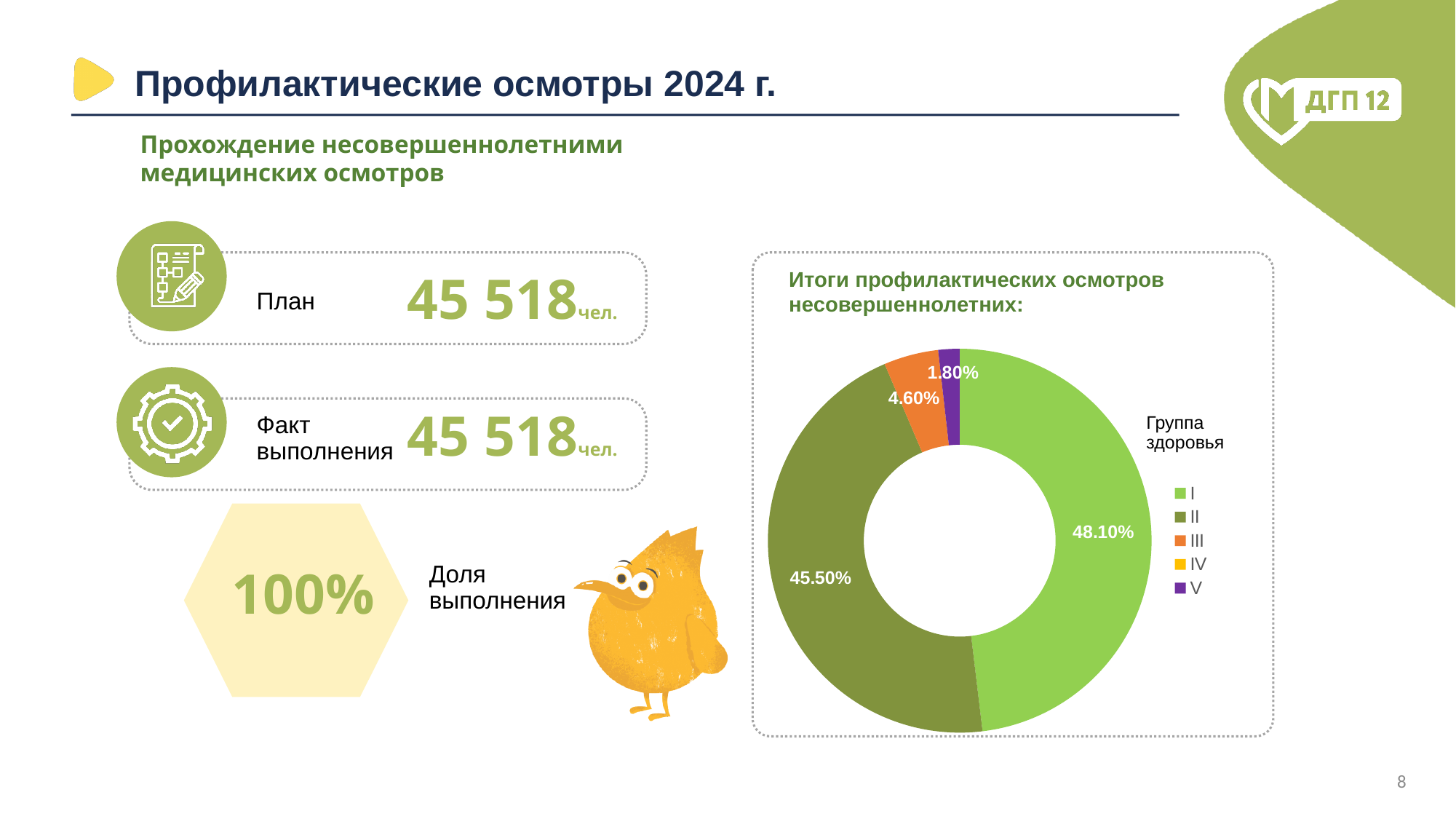
What share of the doughnut chart is labelled for health group V? 1.80% What colour is the slice for health group III in the doughnut chart? Orange Which labelled health group has the smallest share in the doughnut chart? V What share of the doughnut chart is labelled for health group II? 45.50% What kind of chart is shown on the slide? Doughnut (pie) chart What share of the doughnut chart is labelled for health group III? 4.60% What share of the doughnut chart is labelled for health group I? 48.10% What is the difference in percentage points between health group III and health group V in the doughnut chart? 2.80% How many health groups does the legend of the doughnut chart list? 5 Which health group has the largest share in the doughnut chart? I What is the difference in percentage points between health group I and health group II in the doughnut chart? 2.60% Which has a larger share in the doughnut chart, health group III or health group V? III